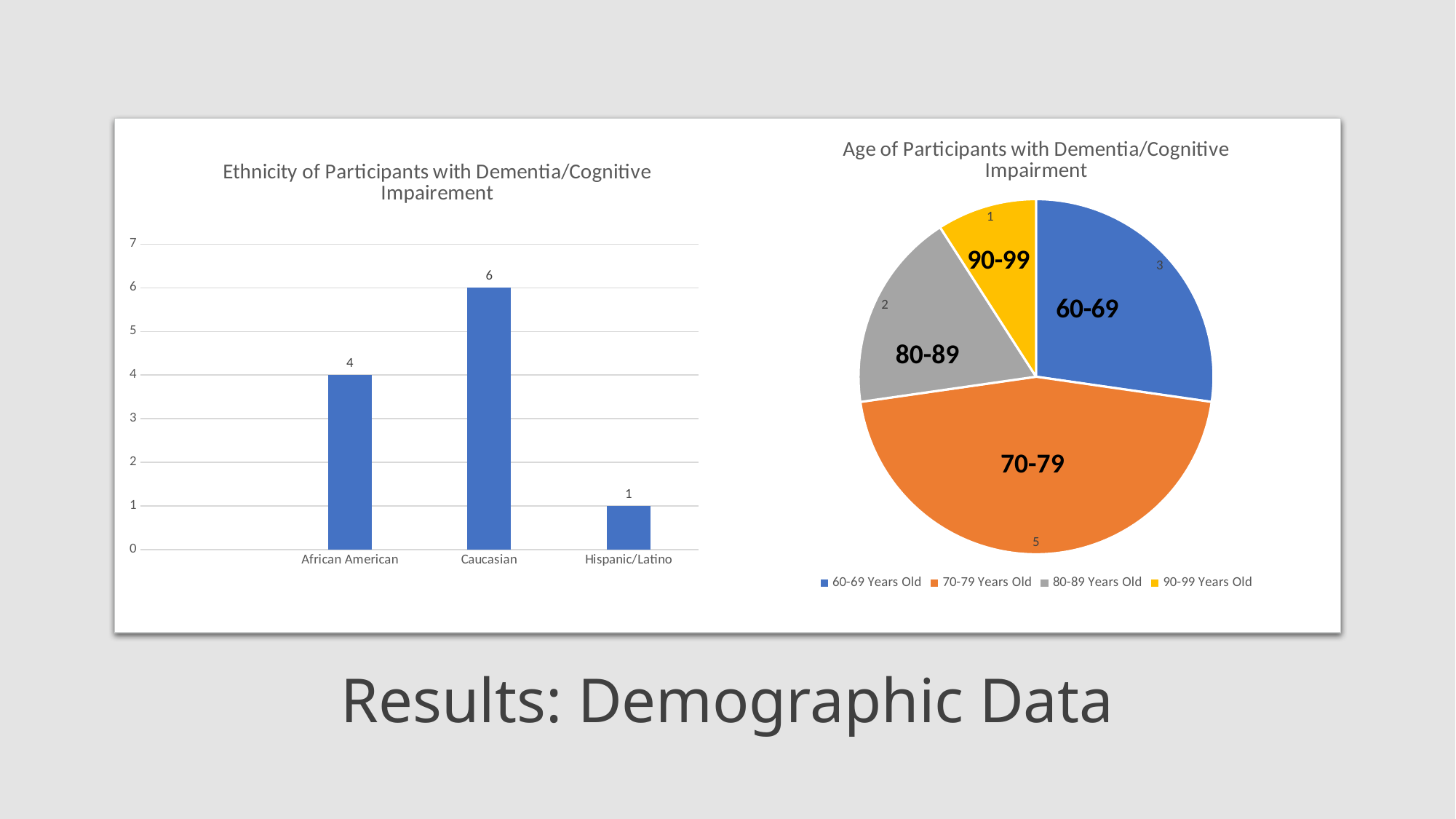
In the 'Age of Participants with Dementia/Cognitive Impairment' chart, which age group has the smallest slice? 90-99 Years Old In the 'Ethnicity of Participants with Dementia/Cognitive Impairement' chart, how many categories are shown on the x axis? 3 In the 'Age of Participants with Dementia/Cognitive Impairment' chart, how many entries does the legend list? 4 What kind of chart is the 'Ethnicity of Participants with Dementia/Cognitive Impairement' chart? Bar chart In the 'Age of Participants with Dementia/Cognitive Impairment' chart, which is larger, the 60-69 Years Old slice or the 80-89 Years Old slice? 60-69 Years Old In the 'Ethnicity of Participants with Dementia/Cognitive Impairement' chart, which category has the highest value? Caucasian In the 'Age of Participants with Dementia/Cognitive Impairment' chart, what is the value for the 70-79 Years Old slice? 5 In the 'Ethnicity of Participants with Dementia/Cognitive Impairement' chart, which category has the lowest value? Hispanic/Latino In the 'Ethnicity of Participants with Dementia/Cognitive Impairement' chart, what is the difference between the values for Caucasian and African American? 2 In the 'Age of Participants with Dementia/Cognitive Impairment' chart, what colour is the 80-89 Years Old slice? Grey In the 'Ethnicity of Participants with Dementia/Cognitive Impairement' chart, what is the value for African American? 4 In the 'Ethnicity of Participants with Dementia/Cognitive Impairement' chart, what is the value for Caucasian? 6